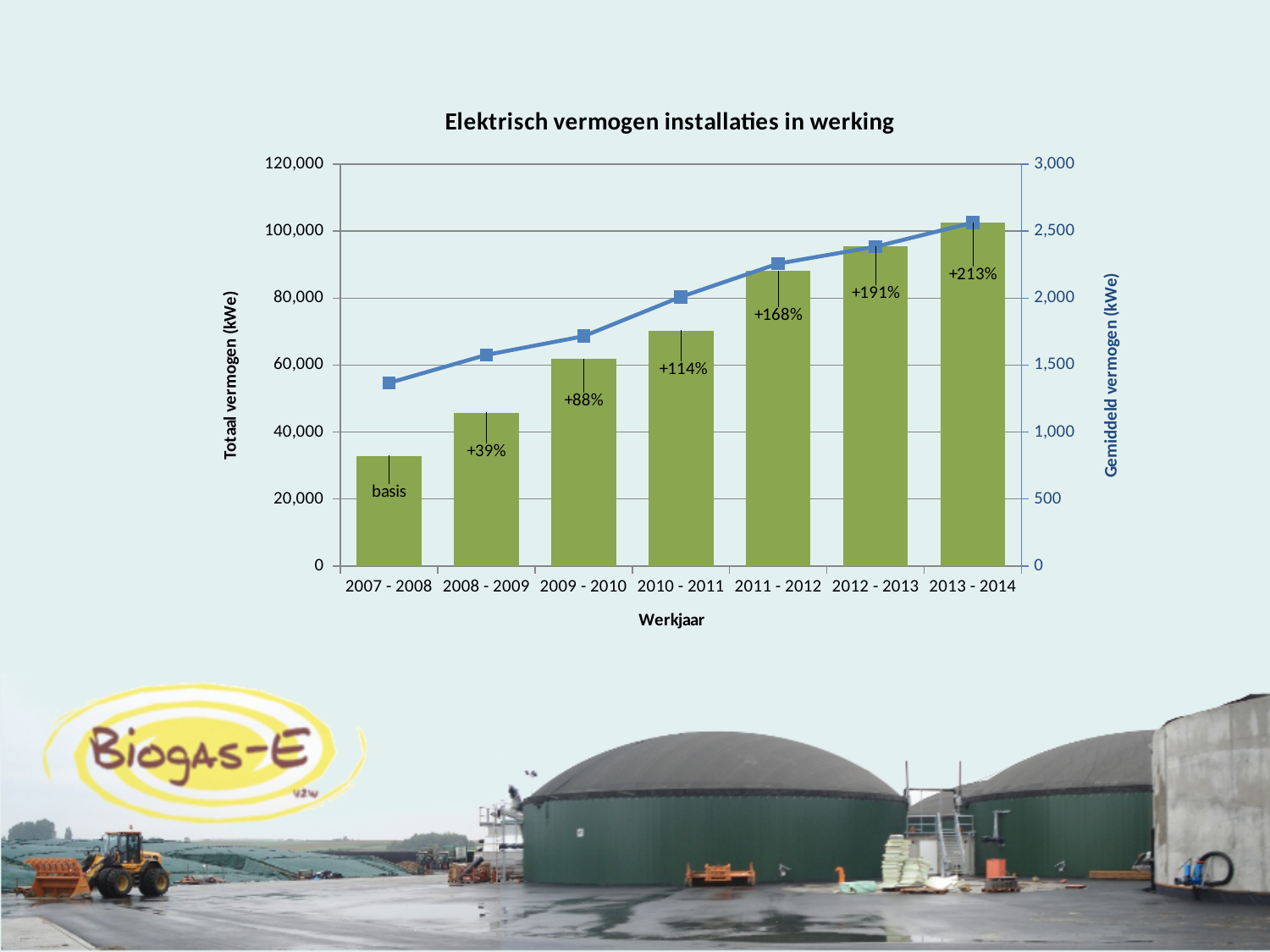
What is the title of the chart? Elektrisch vermogen installaties in werking How many werkjaar categories are shown on the x axis? 7 What label is printed on the bar for 2013 - 2014? +213% What label is printed on the bar for 2007 - 2008? basis Which werkjaar has the lowest total vermogen bar? 2007 - 2008 Is the total vermogen bar for 2010 - 2011 greater or less than 60,000? greater Which werkjaar has the highest total vermogen bar? 2013 - 2014 What label is printed on the bar for 2011 - 2012? +168% Is the total vermogen bar for 2008 - 2009 greater or less than 60,000? less Do the total vermogen bars rise or fall from 2007 - 2008 to 2013 - 2014? rise What label is printed on the bar for 2009 - 2010? +88%